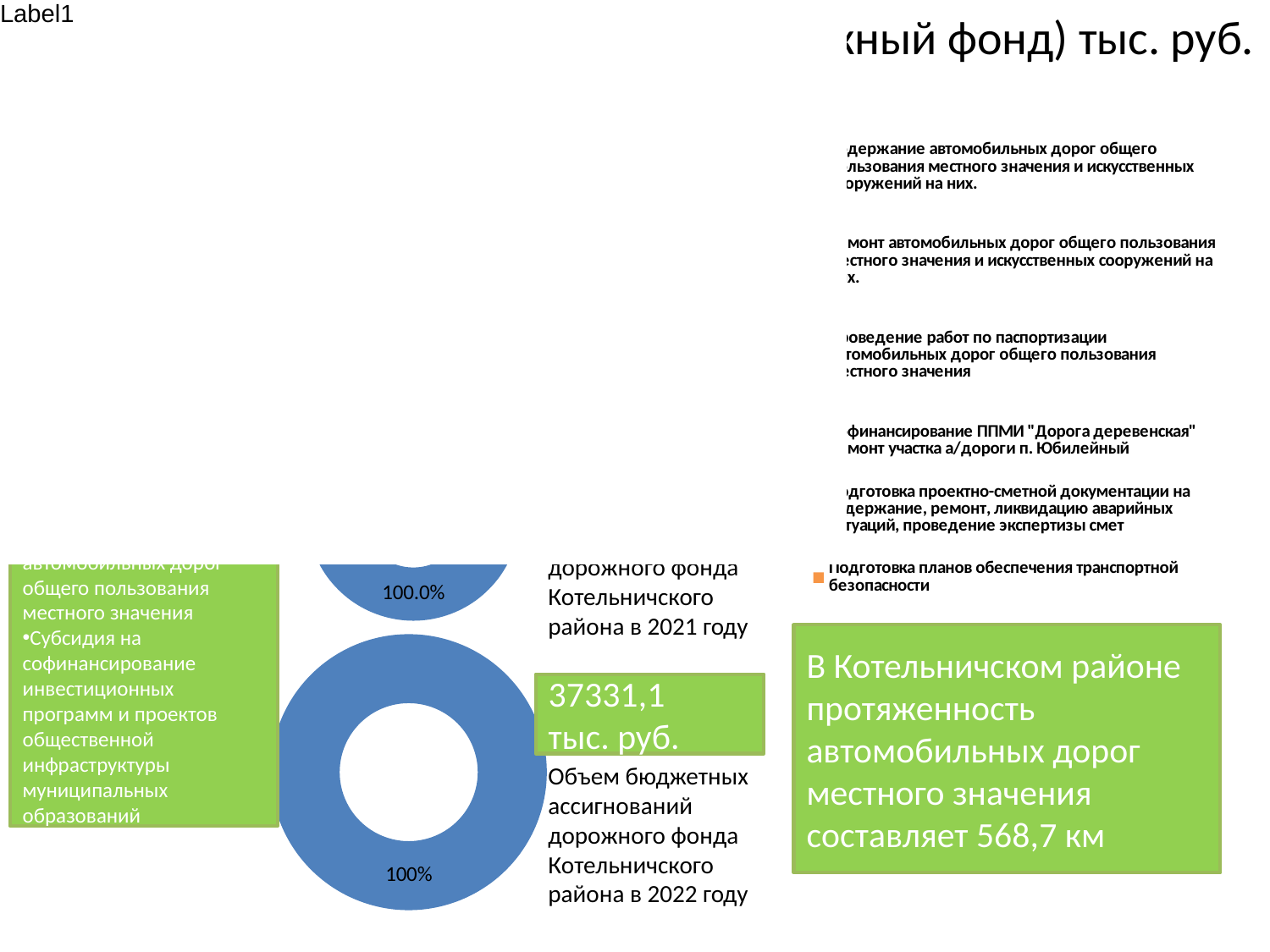
How many entries does the legend on the right side of the slide list? 6 What is the last entry in the legend on the right side of the slide? подготовка планов обеспечения транспортной безопасности What colour is the doughnut chart at the bottom left of the slide? blue What value is printed on the blue doughnut chart at the bottom left of the slide? 100% What kind of chart is the blue chart at the bottom left of the slide? doughnut (pie) chart What value is printed on the partially visible doughnut chart above the bottom-left doughnut? 100.0% How many slices does the blue doughnut chart at the bottom left of the slide have? 1 What share of the bottom-left doughnut chart does its single slice take up? 100%